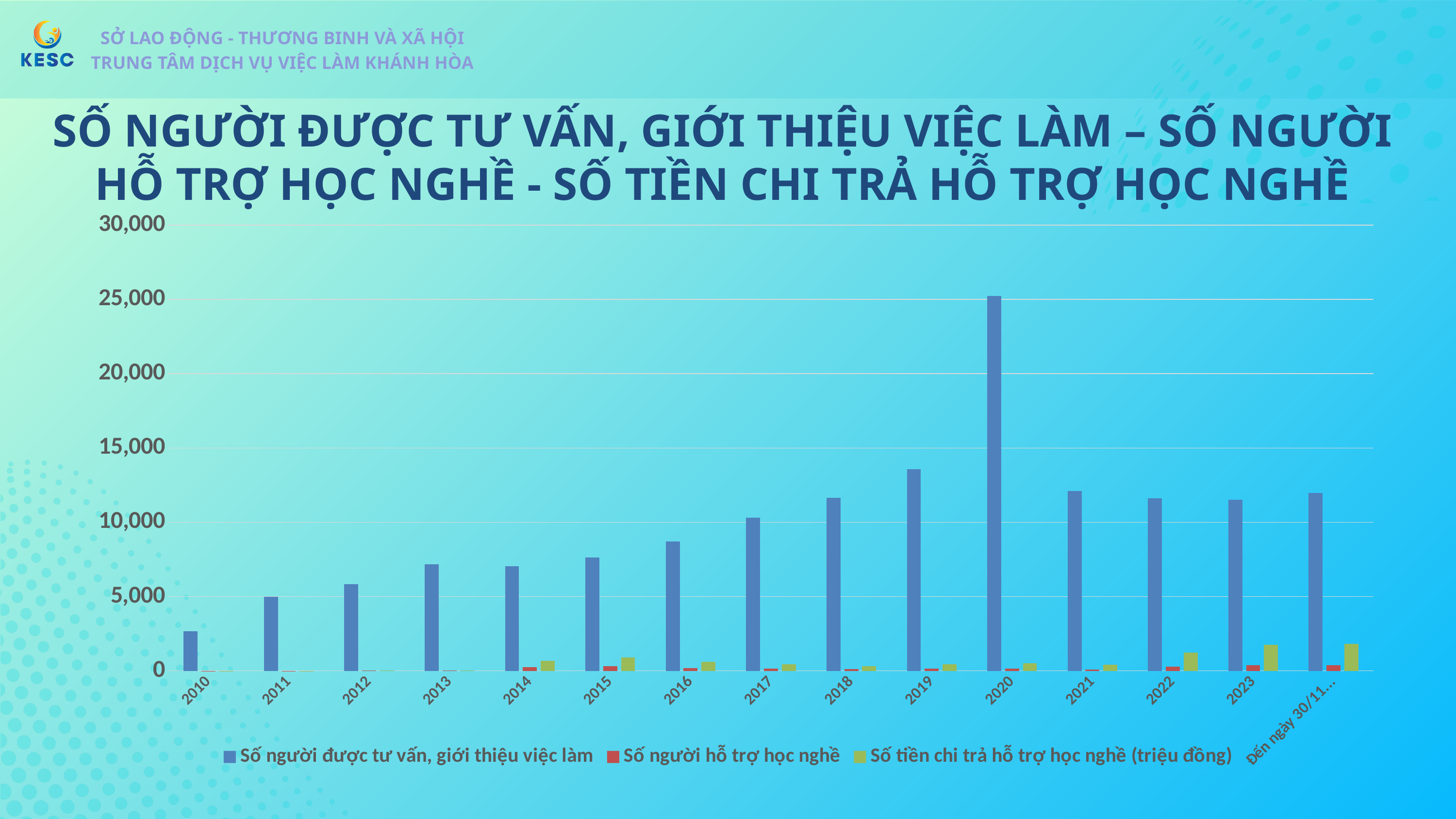
Is the value for 'Số người được tư vấn, giới thiệu việc làm' in 2016 greater or less than 10,000? less Which year has the larger value for 'Số người được tư vấn, giới thiệu việc làm', 2018 or 2019? 2019 Is the value for 'Số người được tư vấn, giới thiệu việc làm' in 2010 greater or less than 5,000? less Which series is shown in red in the legend? Số người hỗ trợ học nghề Is the value for 'Số người được tư vấn, giới thiệu việc làm' in 2020 greater or less than 20,000? greater Do the values for 'Số người được tư vấn, giới thiệu việc làm' rise or fall from 2010 to 2013? rise Which year has the highest value for 'Số người được tư vấn, giới thiệu việc làm'? 2020 What kind of chart is shown on the slide? bar chart How many categories are shown along the x axis? 15 How many series does the legend list? 3 Which year has the lowest value for 'Số người được tư vấn, giới thiệu việc làm'? 2010